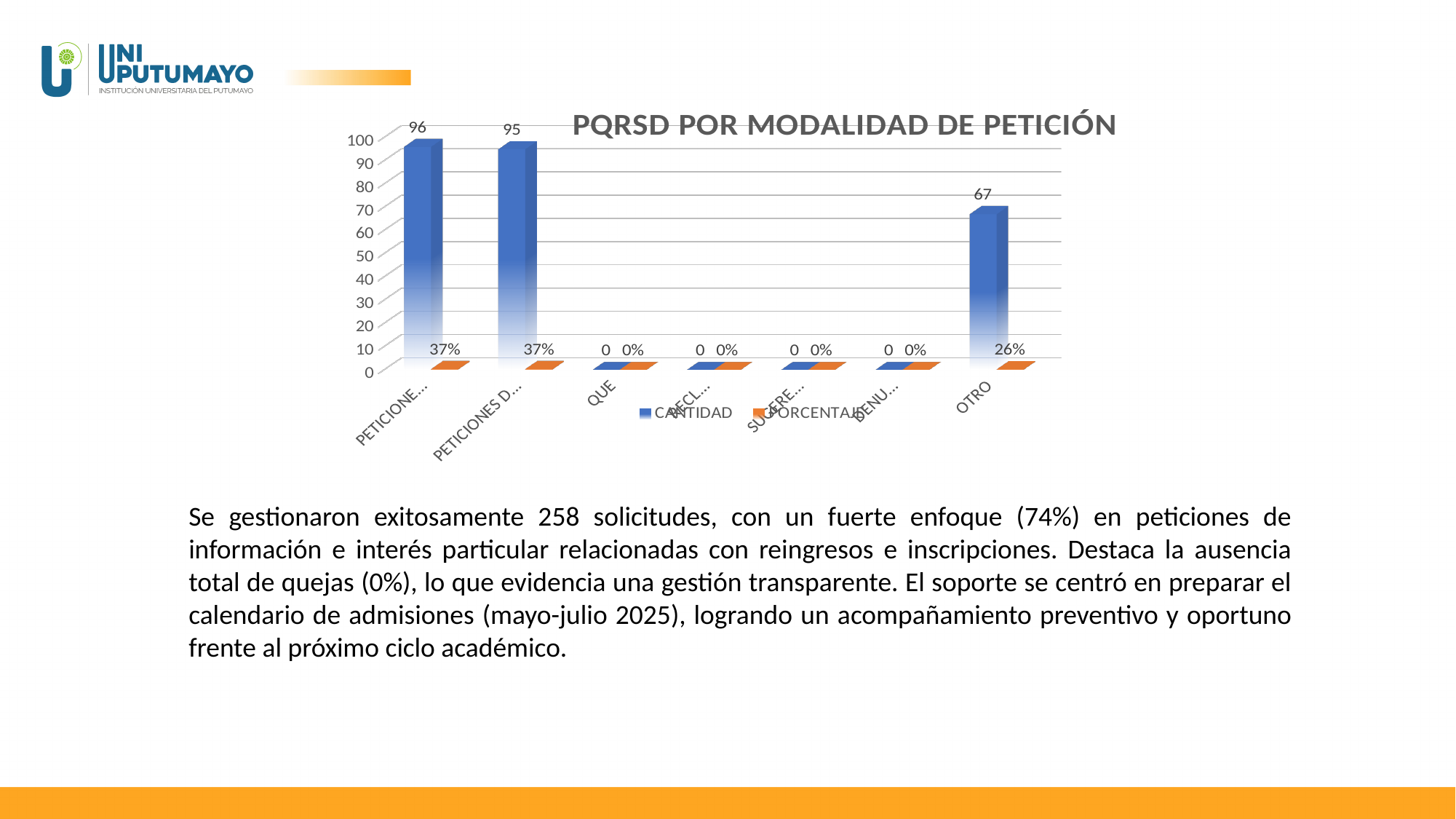
Is the CANTIDAD value for OTRO greater or less than 70? less How many series does the chart legend list? 2 How many categories have a CANTIDAD value of 0? 4 How many categories are shown along the x axis of the chart? 7 What is the CANTIDAD value for the first category on the x axis? 96 What are the two series named in the chart legend? CANTIDAD and PORCENTAJE What is the CANTIDAD value for the OTRO category? 67 What is the PORCENTAJE value for the OTRO category? 26% What kind of chart is shown on the slide? bar chart What is the difference in CANTIDAD between the first category and OTRO? 29 What is the CANTIDAD value for the second category on the x axis? 95 What is the title of the chart? PQRSD POR MODALIDAD DE PETICIÓN